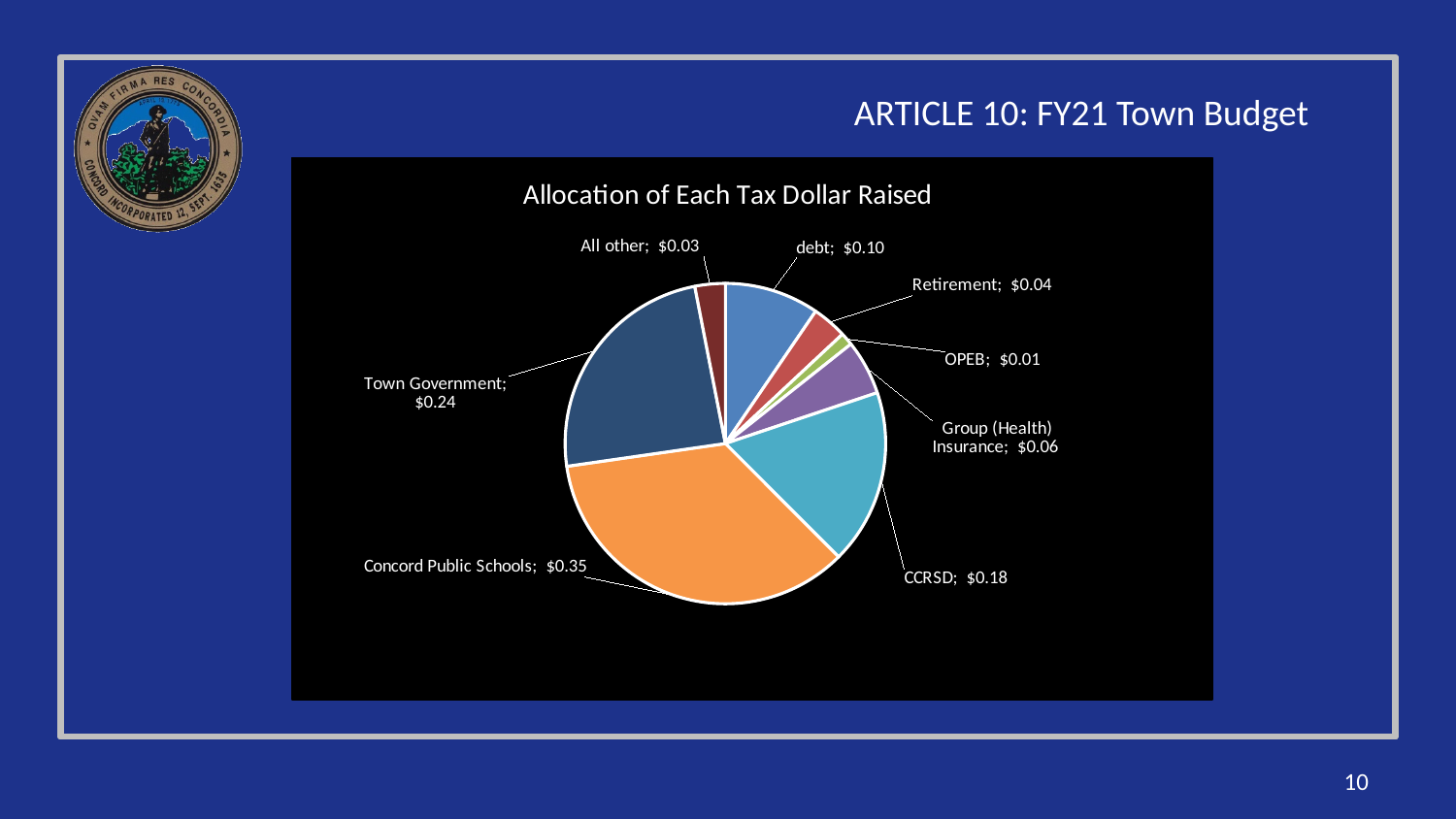
What is the value for Town Government? $0.24 Which is larger, the value for debt or the value for Retirement? debt What is the title of the chart? Allocation of Each Tax Dollar Raised What is the value for Concord Public Schools? $0.35 What is the value for CCRSD? $0.18 How many categories are shown in the pie chart? 8 What is the difference between the values for Concord Public Schools and Town Government? $0.11 What is the combined value of Concord Public Schools and CCRSD? $0.53 What kind of chart is shown on the slide? Pie chart Which category has the smallest slice? OPEB What is the value for Group (Health) Insurance? $0.06 Which category has the largest slice? Concord Public Schools